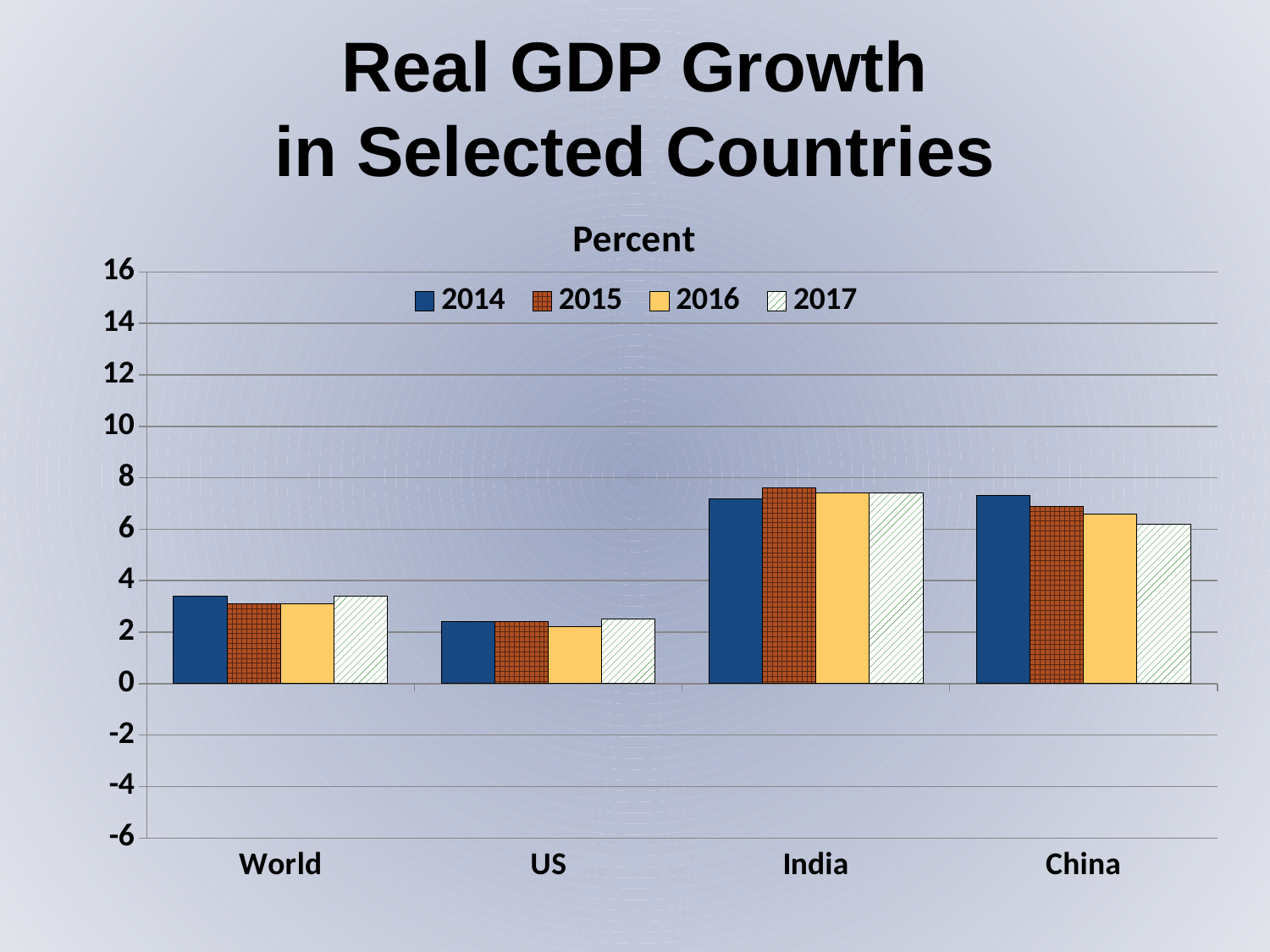
Which years are listed in the legend? 2014, 2015, 2016, 2017 Is the value for the US in 2016 greater or less than 4? less Is the value for India in 2015 greater or less than 6? greater What label appears above the chart's y axis? Percent Is the value for China in 2017 greater or less than 8? less Which is larger, the 2014 value for India or the 2014 value for the US? India Which country or region has the lowest bar for 2016? US What kind of chart is shown on the slide? bar chart Do China's values rise or fall from 2014 to 2017? fall How many series does the legend list? 4 Which country or region has the highest bar for 2015? India How many countries or regions are shown on the x axis? 4